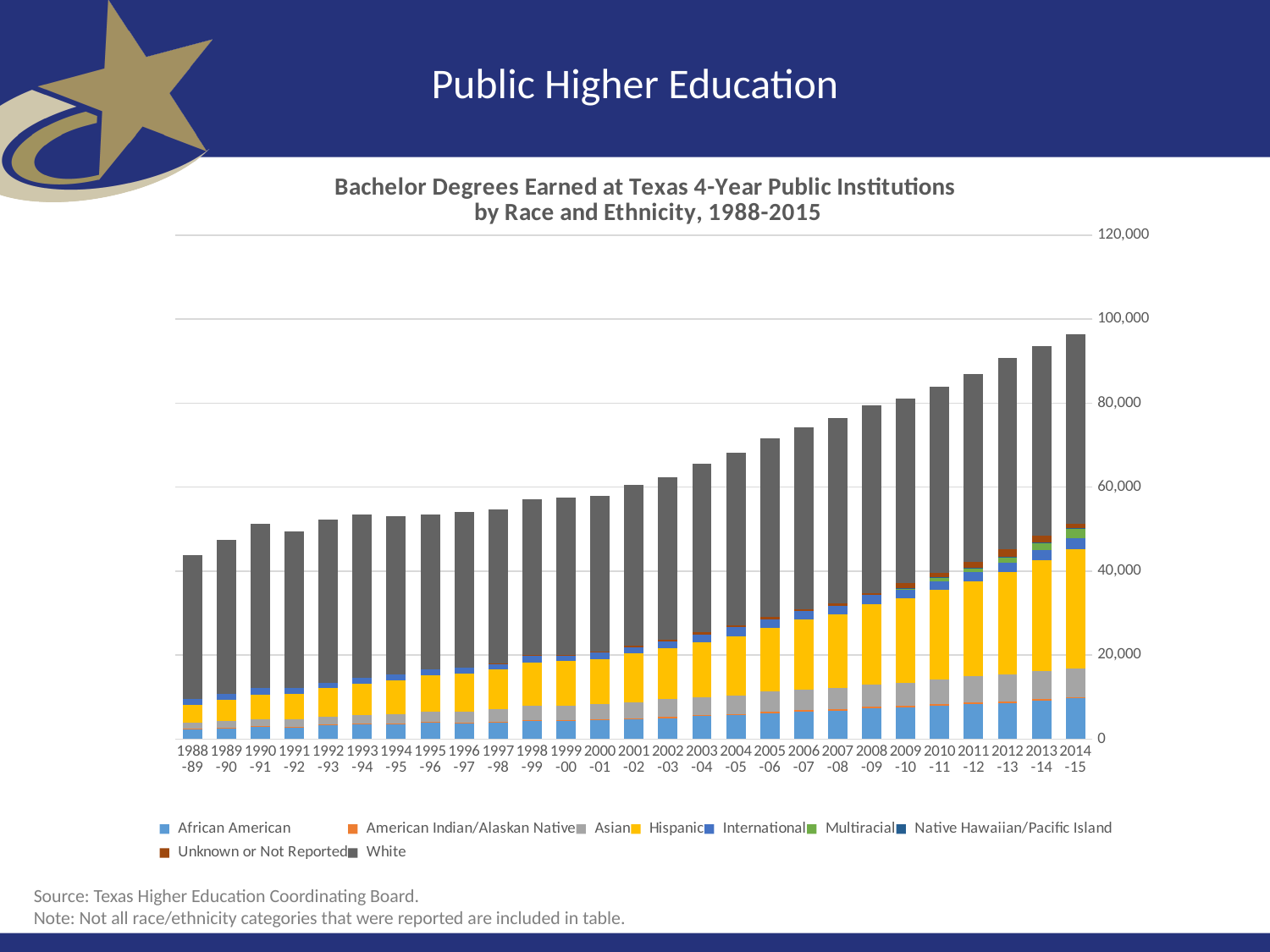
What is the title of the chart? Bachelor Degrees Earned at Texas 4-Year Public Institutions by Race and Ethnicity, 1988-2015 Is the total number of bachelor degrees for 1988-89 greater or less than 60,000? less Overall, do total bachelor degrees earned rise or fall from 1988-89 to 2014-15? Rise Which year has a larger total of bachelor degrees, 2005-06 or 1995-96? 2005-06 How many race/ethnicity series does the legend list? 9 What kind of chart is shown on the slide? Stacked bar chart Which academic year has the lowest total number of bachelor degrees earned? 1988-89 Which series is shown in yellow in the chart? Hispanic How many academic years are shown along the x axis of the chart? 27 Is the total number of bachelor degrees for 2014-15 greater or less than 80,000? greater Which academic year has the highest total number of bachelor degrees earned? 2014-15 Is the total number of bachelor degrees for 2000-01 greater or less than 60,000? less